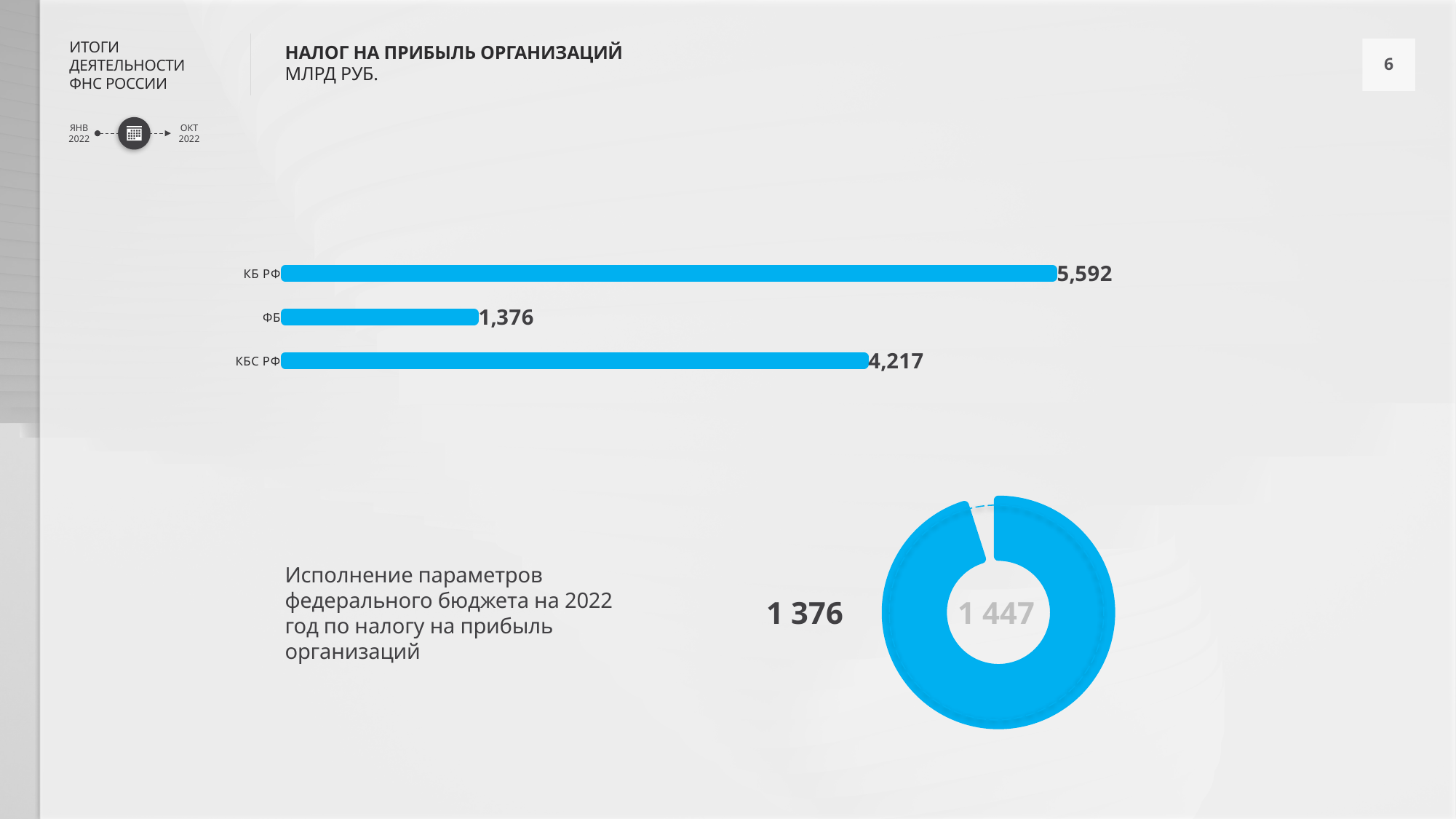
In the bar chart at the top of the slide, what is the value for КБ РФ? 5,592 In the donut chart at the bottom of the slide, what value is labelled to the left of the ring? 1 376 In the donut chart at the bottom of the slide, what value is printed in the centre of the ring? 1 447 In the bar chart at the top of the slide, what is the difference between the values for КБ РФ and КБС РФ? 1,375 In the bar chart at the top of the slide, which category has the highest value? КБ РФ What kind of chart is shown at the top of the slide? bar chart How many categories are shown in the bar chart at the top of the slide? 3 In the bar chart at the top of the slide, which category has the lowest value? ФБ In the bar chart at the top of the slide, what is the value for ФБ? 1,376 In the bar chart at the top of the slide, what is the value for КБС РФ? 4,217 In the bar chart at the top of the slide, what is the difference between the values for КБС РФ and ФБ? 2,841 In the bar chart at the top of the slide, which is larger, the value for КБС РФ or the value for ФБ? КБС РФ